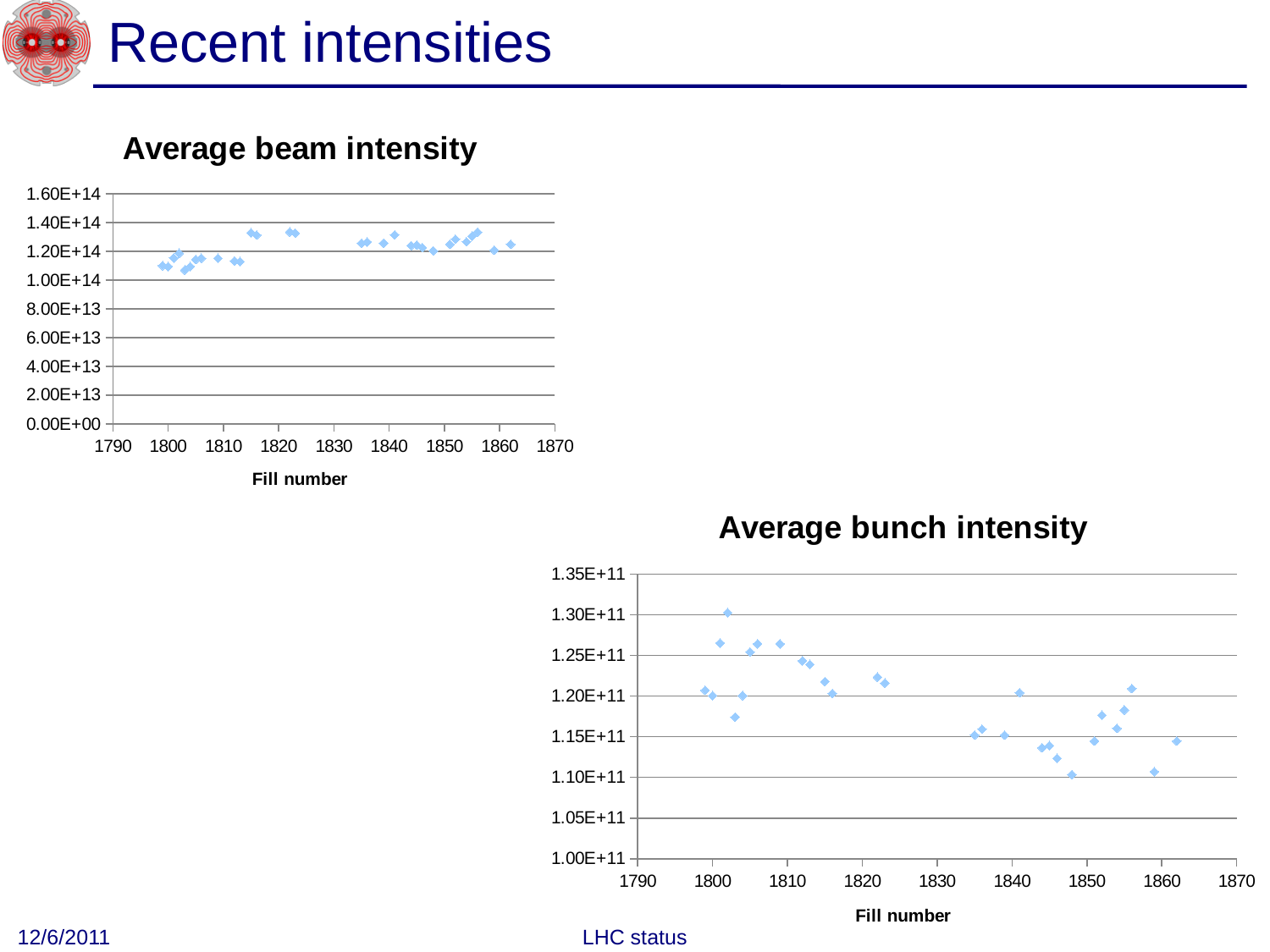
In the "Average beam intensity" chart, do the values generally rise or fall as the fill number increases? rise What is the title of the chart in the lower right of the slide? Average bunch intensity In the "Average bunch intensity" chart, is the highest point (near fill 1802) greater or less than 1.25E+11? greater What kind of chart is the "Average beam intensity" chart? scatter chart In the "Average beam intensity" chart, are the plotted values greater or less than 1.00E+14? greater What is the x-axis label on the "Average beam intensity" chart? Fill number In the "Average bunch intensity" chart, is the lowest point (near fill 1848) greater or less than 1.15E+11? less What is the highest y-axis tick value shown on the "Average bunch intensity" chart? 1.35E+11 In the "Average bunch intensity" chart, do the values generally rise or fall as the fill number increases? fall What kind of chart is the "Average bunch intensity" chart? scatter chart